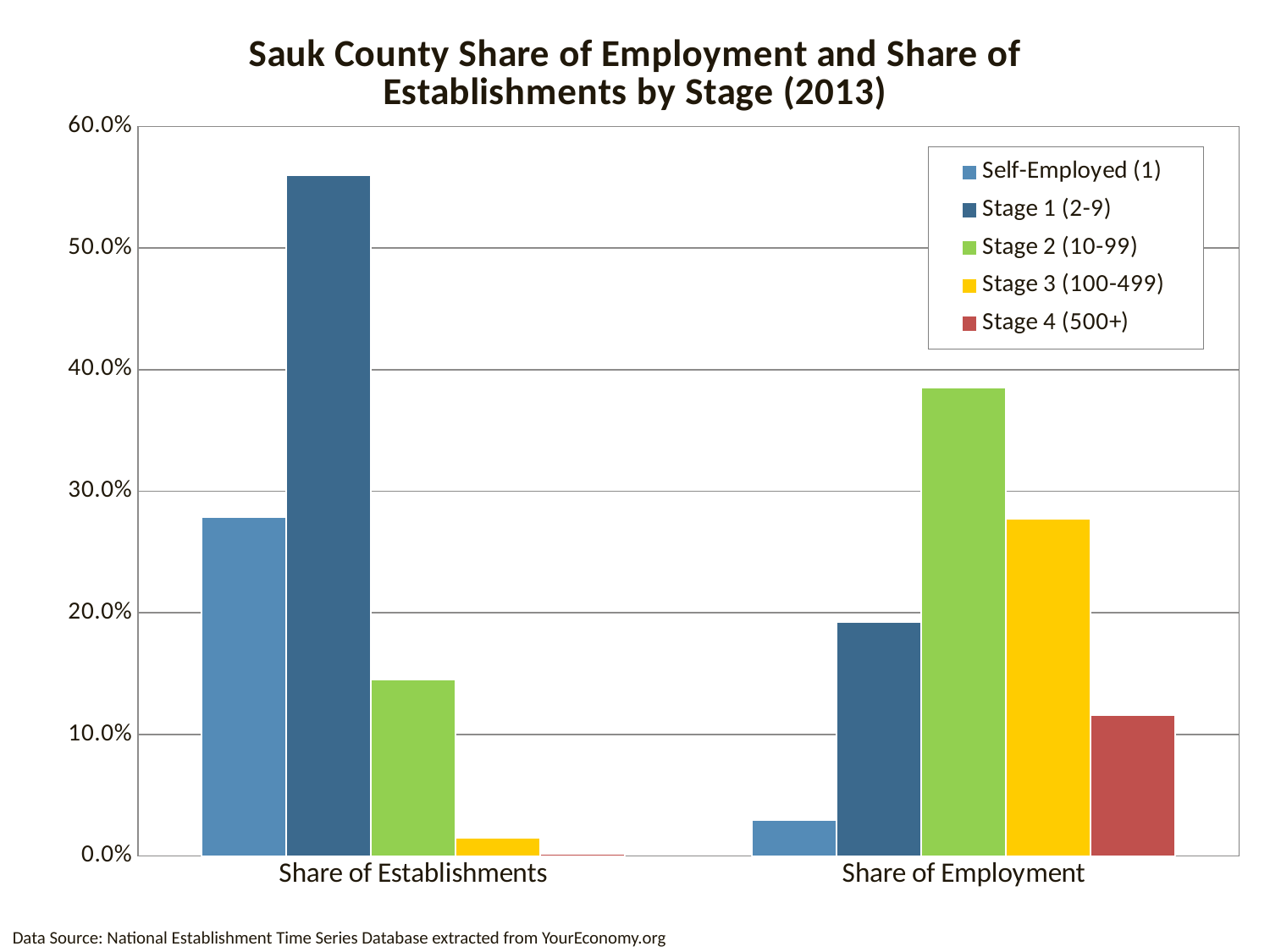
Which series has the highest value for Share of Establishments? Stage 1 (2-9) Which series has the highest value for Share of Employment? Stage 2 (10-99) What is the title of the chart? Sauk County Share of Employment and Share of Establishments by Stage (2013) For Share of Employment, which is larger: Stage 3 (100-499) or Stage 1 (2-9)? Stage 3 (100-499) Is the value for Stage 4 (500+) in Share of Employment greater or less than 10.0%? greater Which series has the lowest value for Share of Employment? Self-Employed (1) Is the value for Stage 2 (10-99) in Share of Employment greater or less than 40.0%? less How many series does the legend list? 5 Which series has the lowest value for Share of Establishments? Stage 4 (500+) What kind of chart is shown on the slide? bar chart How many categories are shown on the x axis? 2 Is the value for Stage 1 (2-9) in Share of Establishments greater or less than 50.0%? greater